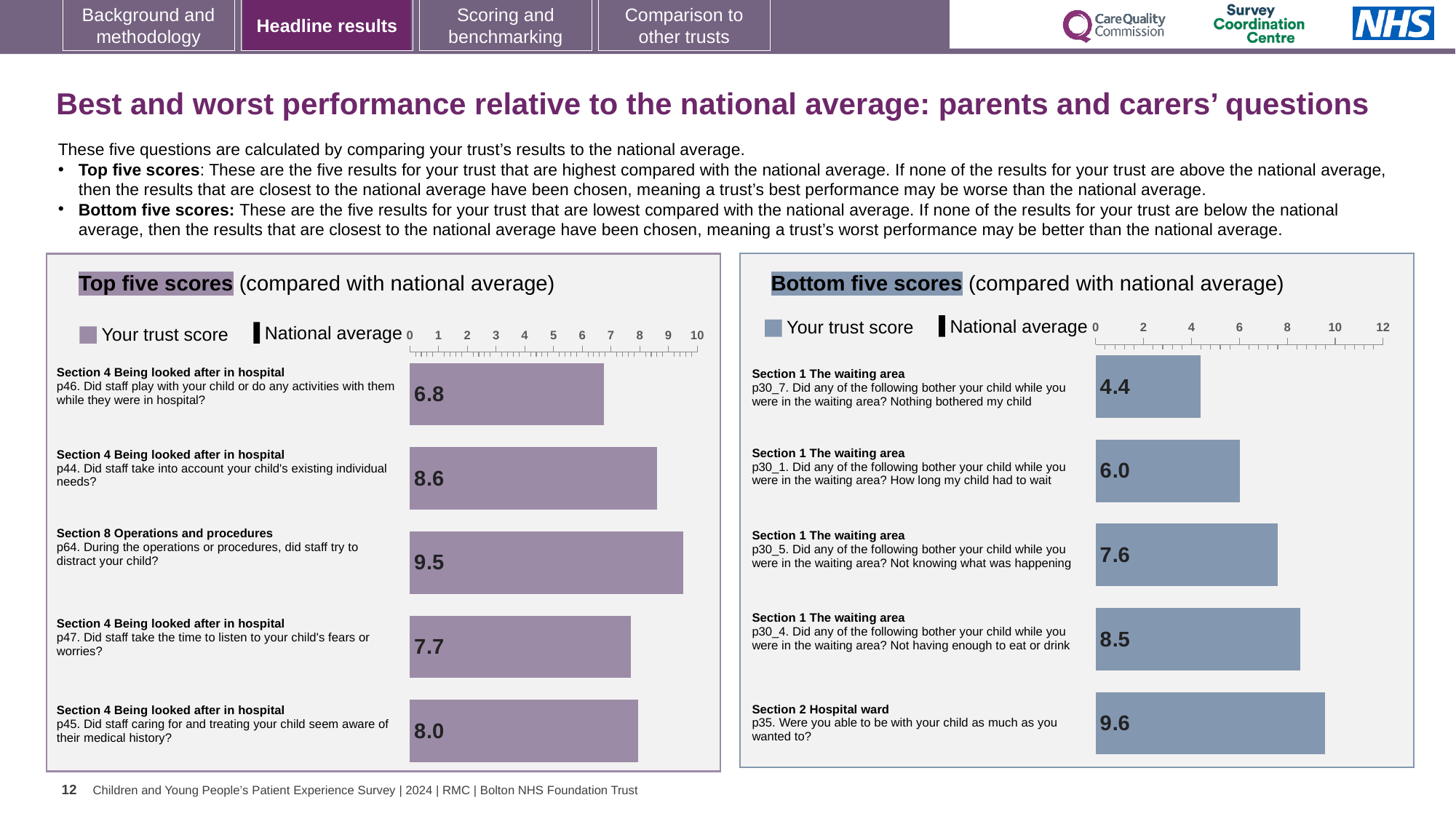
In the Bottom five scores chart, what is the trust score for p35 (were you able to be with your child as much as you wanted to)? 9.6 In the Top five scores chart, what is the trust score for p64 (did staff try to distract your child during operations or procedures)? 9.5 In the Bottom five scores chart, what is the difference between the trust scores for p30_4 and p30_1? 2.5 In the Bottom five scores chart, what is the trust score for p30_7 (nothing bothered my child in the waiting area)? 4.4 In the Top five scores chart, what is the trust score for p46 (did staff play with your child or do any activities with them)? 6.8 In the Bottom five scores chart, which question has the lowest trust score? p30_7. Did any of the following bother your child while you were in the waiting area? Nothing bothered my child In the Top five scores chart, which has the larger trust score: p45 or p46? p45 In the Top five scores chart, what is the difference between the trust scores for p44 and p47? 0.9 In the Top five scores chart, which question has the highest trust score? p64. During the operations or procedures, did staff try to distract your child? How many questions are shown in the Bottom five scores chart? 5 How many series does the legend of the Bottom five scores chart list? 2 What kind of chart is the Top five scores chart? Bar chart